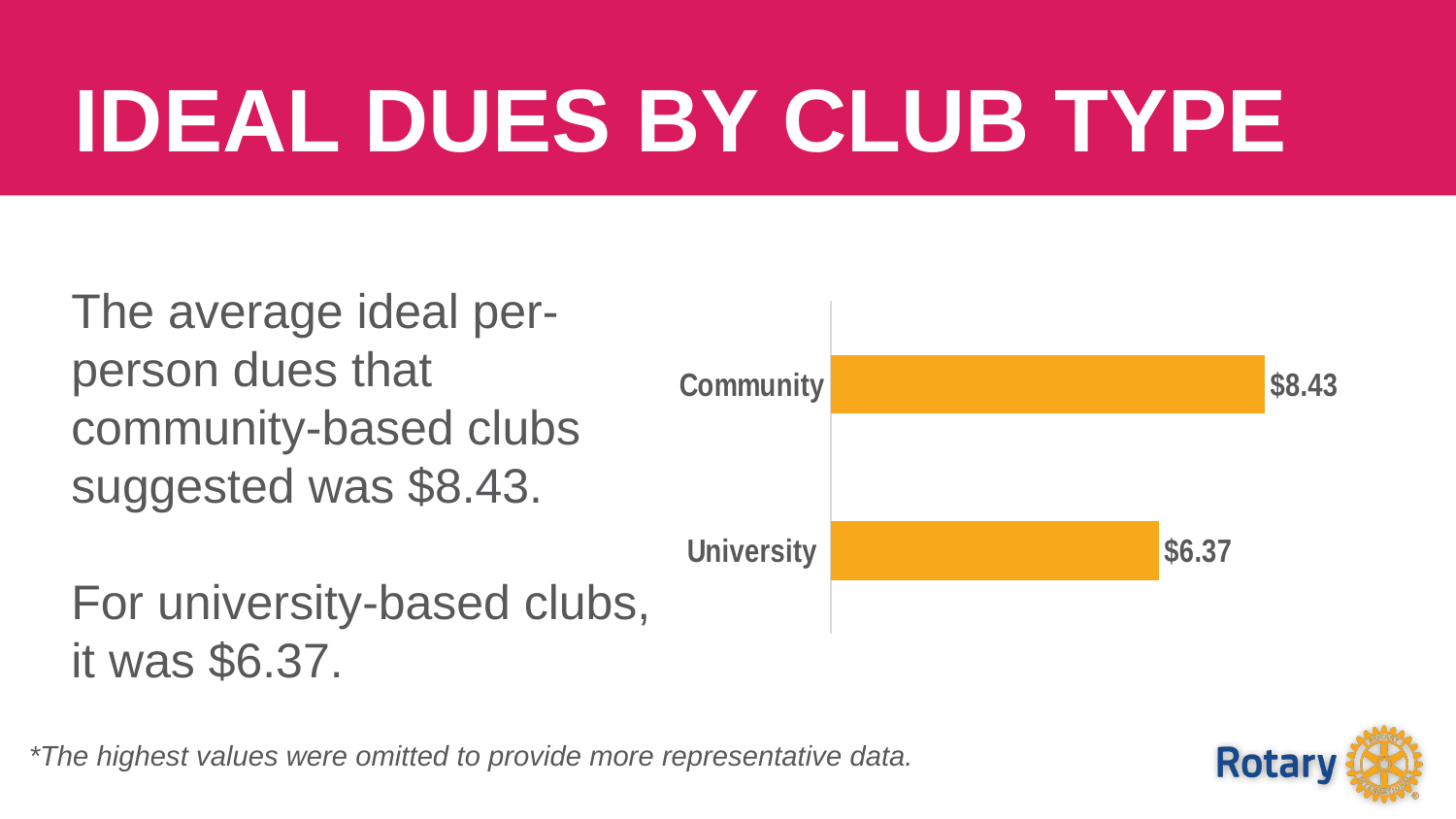
Which club type has the highest ideal dues? Community Which is larger, the value for Community or the value for University? Community What is the difference between the Community and University values? $2.06 What is the value for Community? $8.43 Which club type has the lowest ideal dues? University What is the title of the slide containing the chart? IDEAL DUES BY CLUB TYPE What kind of chart is shown on the slide? Bar chart What is the value for University? $6.37 What colour are the bars in the chart? Orange How many categories are shown in the chart? 2